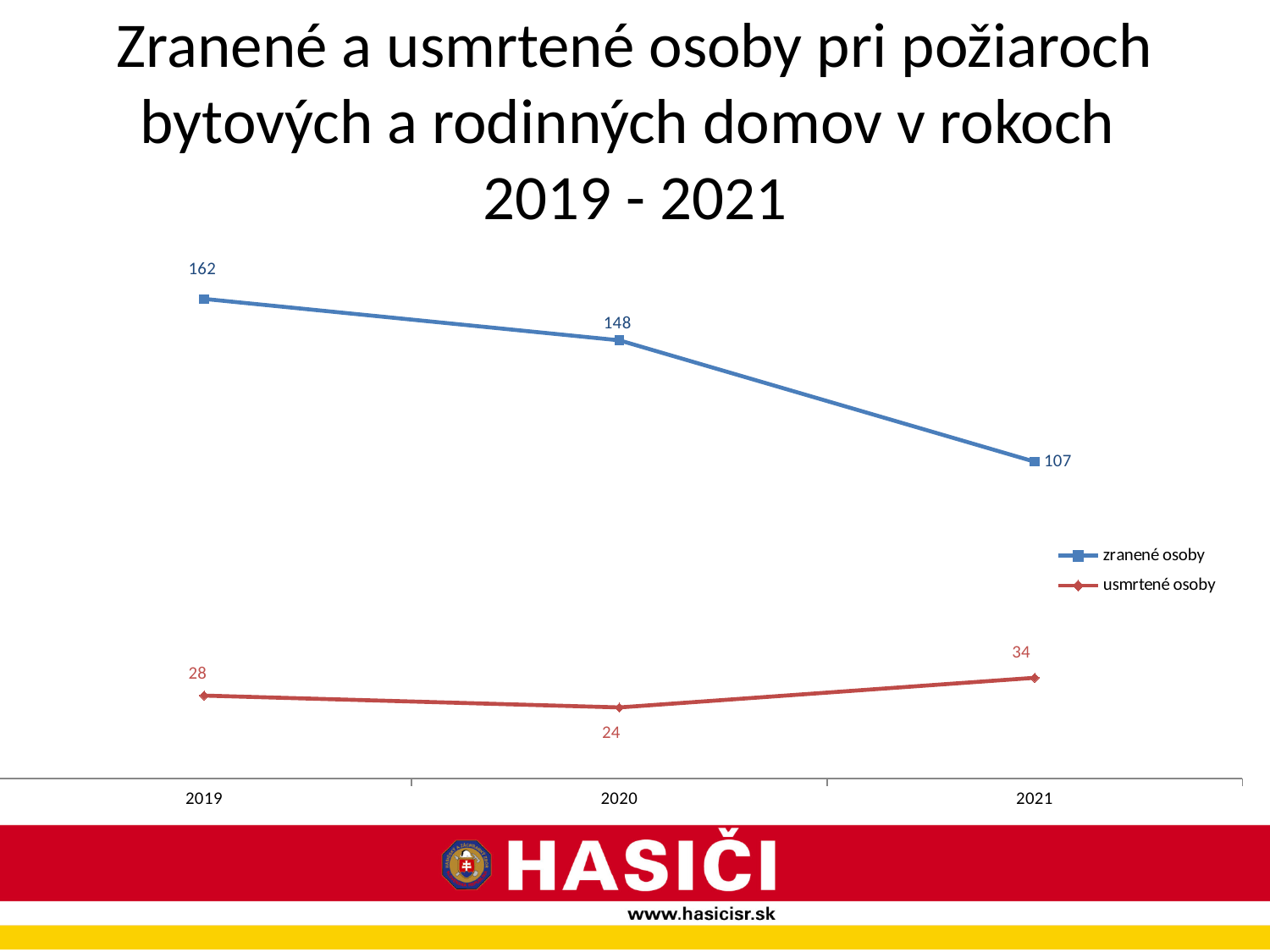
Which is larger: zranené osoby in 2020 or zranené osoby in 2021? zranené osoby in 2020 What is the difference between zranené osoby in 2019 and 2021? 55 What is the value for usmrtené osoby in 2020? 24 In which year is the value for zranené osoby highest? 2019 What kind of chart is shown on the slide? line chart How many years are shown on the x axis? 3 How many series does the legend list? 2 What is the difference between usmrtené osoby in 2021 and 2020? 10 What is the value for zranené osoby in 2021? 107 What is the value for usmrtené osoby in 2021? 34 What is the value for zranené osoby in 2019? 162 In which year is the value for usmrtené osoby lowest? 2020